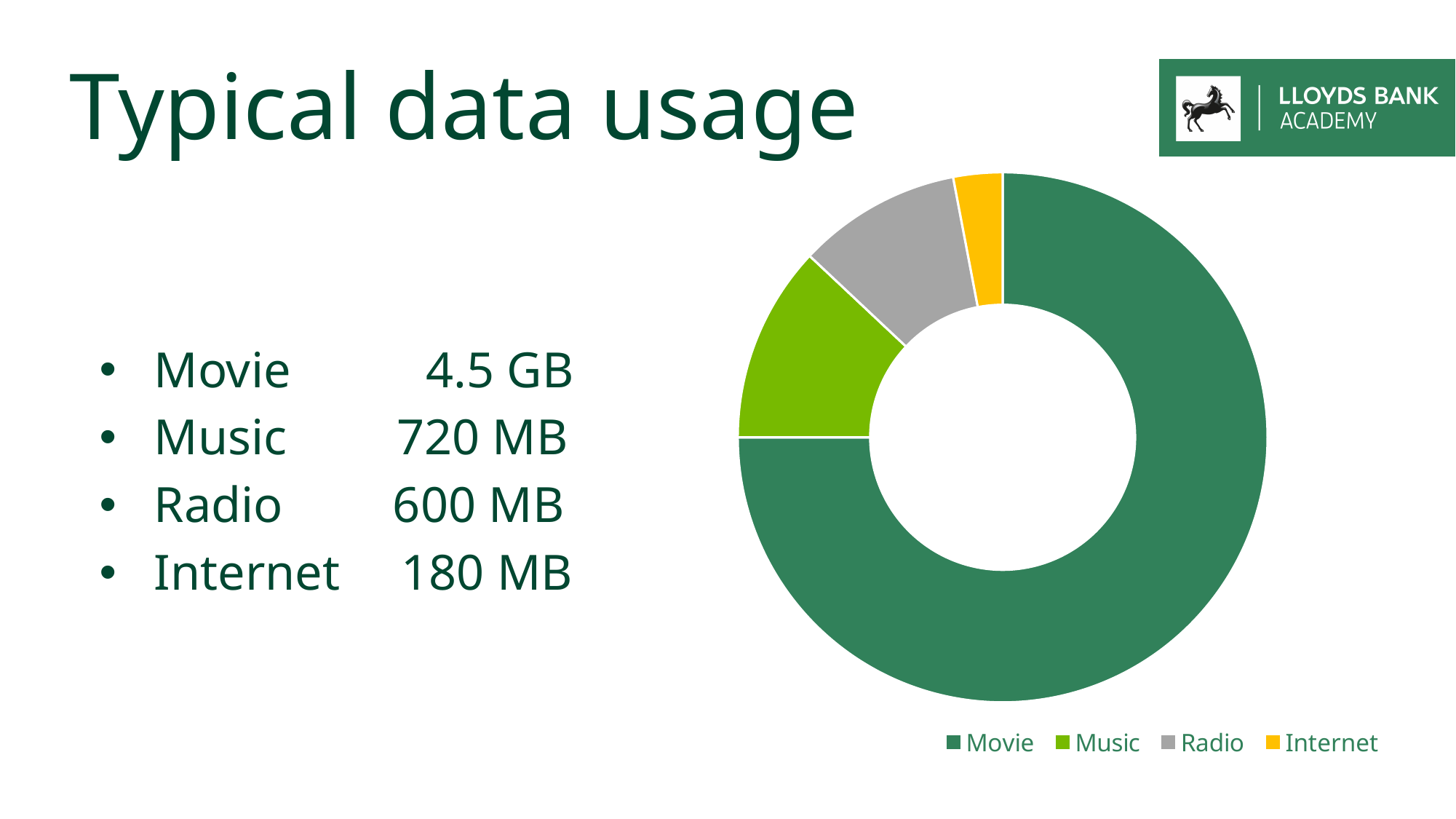
How many categories does the chart show? 4 What is the data usage value given for Music? 720 MB Which category has the smallest slice of the chart? Internet Which uses more data, Music or Radio? Music Which colour represents Internet in the chart? Yellow What is the data usage value given for Movie? 4.5 GB What is the difference between the Music and Radio values? 120 MB What is the data usage value given for Internet? 180 MB Which category has the largest slice of the chart? Movie How many entries does the chart's legend list? 4 What share of the total data usage does Movie represent? 75% What kind of chart is shown on the slide? Pie chart (doughnut)